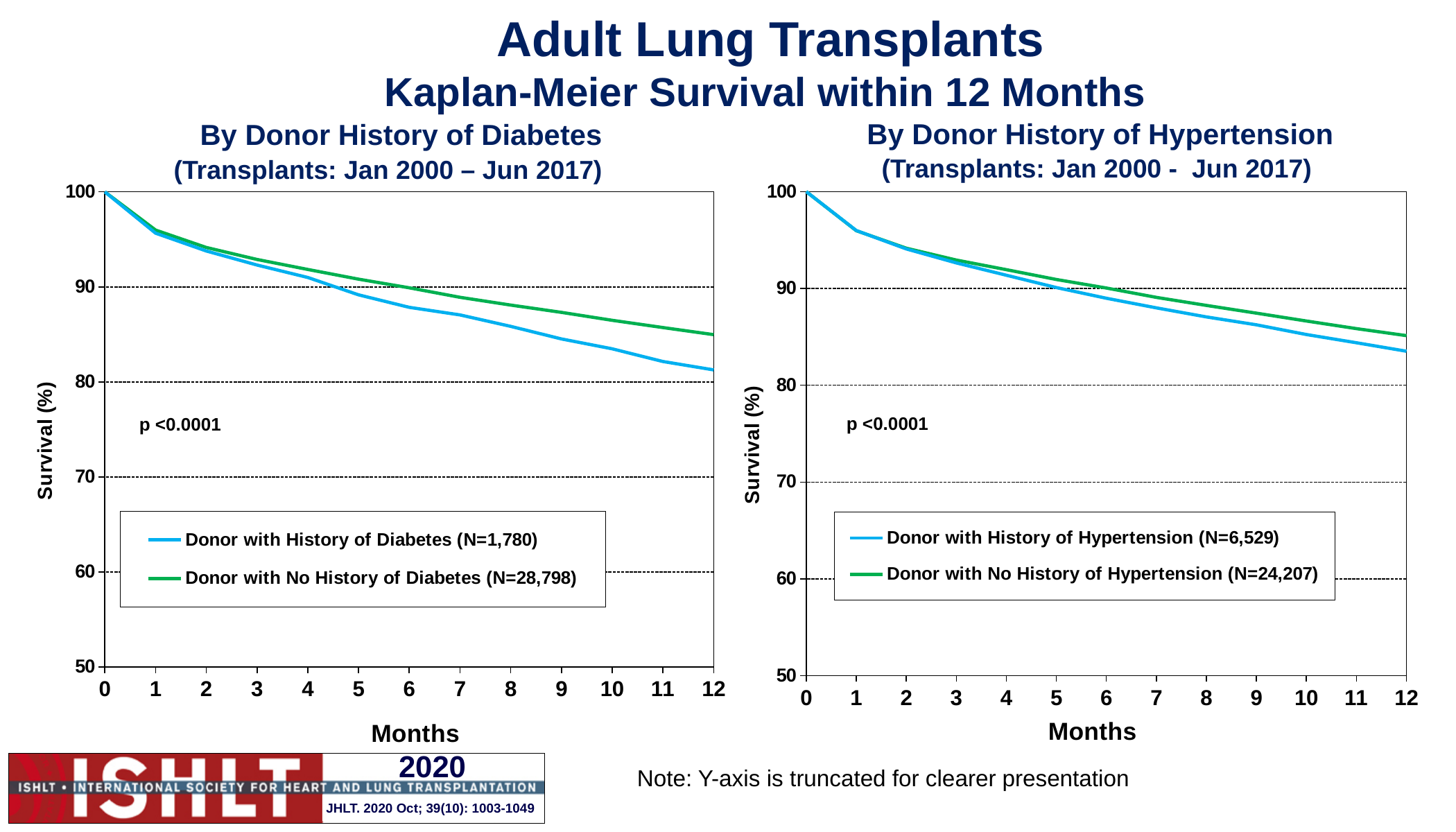
In the 'By Donor History of Hypertension' chart, do the survival curves rise or fall along the x axis? fall In the 'By Donor History of Hypertension' chart, is the survival for Donor with History of Hypertension at month 12 greater or less than 90? less In the 'By Donor History of Diabetes' chart, is the survival for Donor with History of Diabetes at month 12 greater or less than 90? less How many series does the legend of the 'By Donor History of Hypertension' chart list? 2 In the 'By Donor History of Hypertension' chart, which series has higher survival at month 12: Donor with History of Hypertension or Donor with No History of Hypertension? Donor with No History of Hypertension In the 'By Donor History of Diabetes' chart, is the survival for Donor with No History of Diabetes at month 12 greater or less than 80? greater In the 'By Donor History of Hypertension' chart, what is the N for Donor with No History of Hypertension shown in the legend? N=24,207 What kind of chart is the 'By Donor History of Diabetes' chart? line chart In the 'By Donor History of Diabetes' chart, what is the survival value for Donor with History of Diabetes at month 0? 100 In the 'By Donor History of Diabetes' chart, do the survival curves rise or fall as months increase? fall In the 'By Donor History of Diabetes' chart, which series has higher survival at month 12: Donor with History of Diabetes or Donor with No History of Diabetes? Donor with No History of Diabetes What p-value is shown on the 'By Donor History of Diabetes' chart? p <0.0001